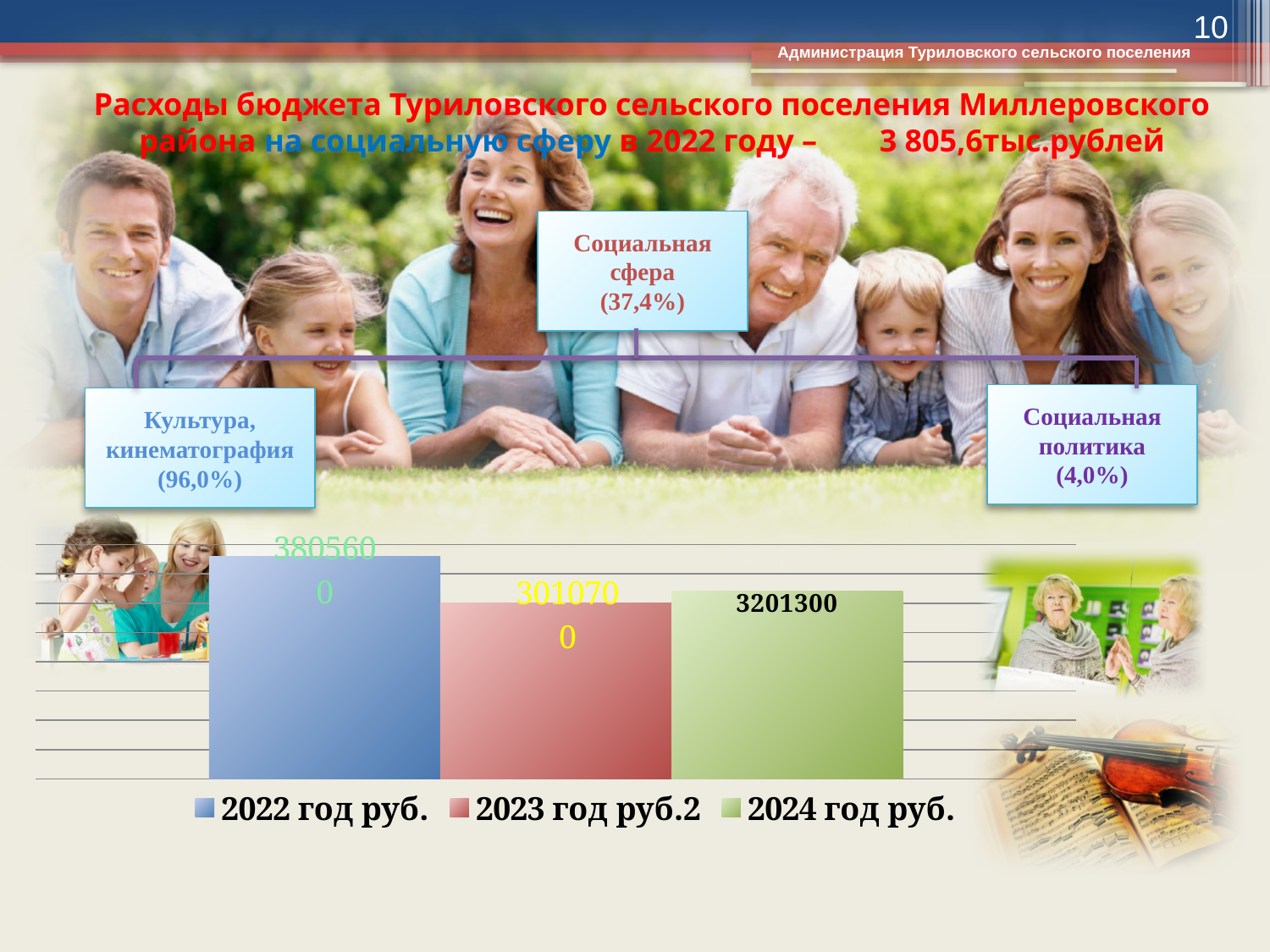
What is the difference between the 2022 год руб. value and the 2023 год руб.2 value? 794900 Does the value fall or rise from 2022 год руб. to 2023 год руб.2? fall How many bars are plotted in the chart? 3 Which is larger, the value for 2024 год руб. or the value for 2023 год руб.2? 2024 год руб. Which year has the highest value in the chart? 2022 год руб. How many entries does the chart legend list? 3 Which year has the lowest value in the chart? 2023 год руб.2 What is the value shown for the 2023 год руб.2 bar? 3010700 What is the value shown for the 2024 год руб. bar? 3201300 What is the value shown for the 2022 год руб. bar? 3805600 What type of chart is shown on the slide? bar chart What is the difference between the 2024 год руб. value and the 2023 год руб.2 value? 190600